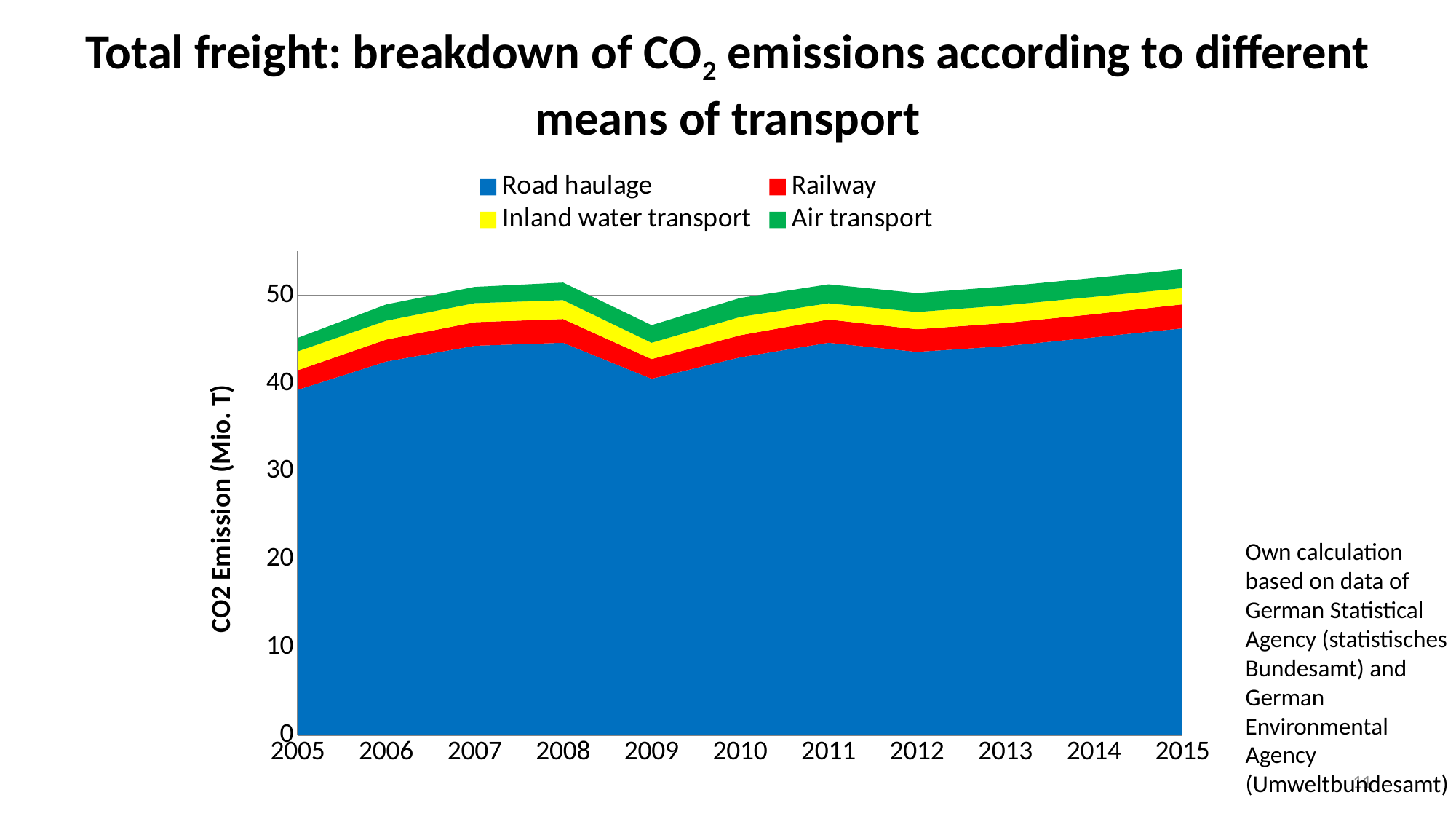
Which means of transport accounts for the largest share of CO2 emissions in every year? Road haulage Does the total CO2 emission rise or fall from 2008 to 2009? fall In which year is the total CO2 emission across all means of transport highest? 2015 Does the Road haulage value rise or fall from 2012 to 2015? rise What kind of chart is shown on the slide? Stacked area chart How many years are shown along the x axis? 11 How many series does the legend list? 4 Is the total CO2 emission in 2015 greater or less than 50? greater Is the value for Road haulage in 2015 greater or less than 40? greater Is the value for Road haulage in 2005 greater or less than 40? less What is the label of the y axis? CO2 Emission (Mio. T)